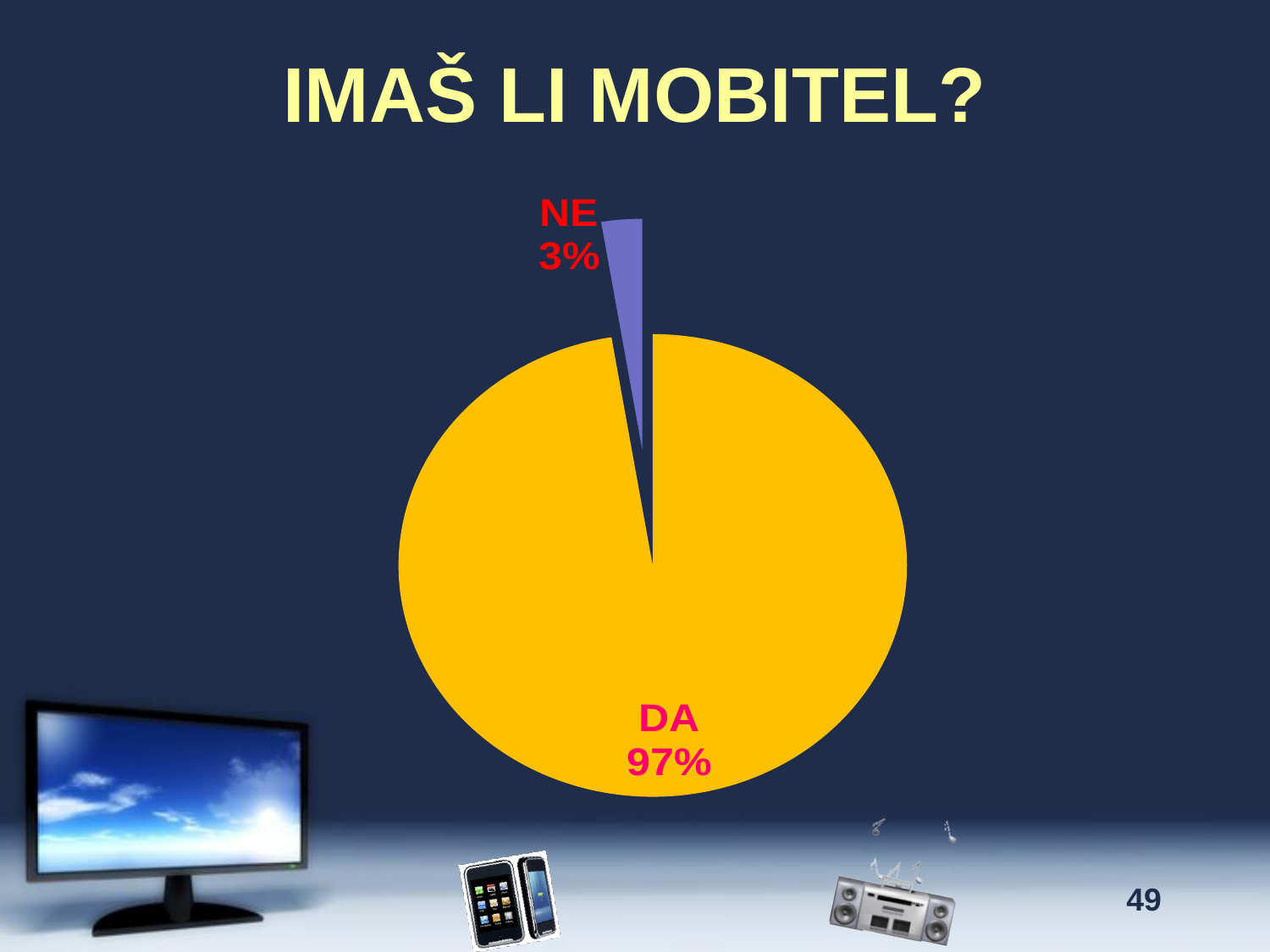
What colour is the DA slice of the pie? yellow Which answer has the smallest share of the pie? NE What is the difference in percentage points between DA and NE? 94 What kind of chart is shown on the slide? pie chart Which answer has the largest share of the pie? DA What is the title of the slide above the chart? IMAŠ LI MOBITEL? What percentage of respondents answered NE? 3% What percentage of respondents answered DA? 97% How many slices does the pie chart have? 2 Which is larger, the share for DA or the share for NE? DA What share of the pie does the NE slice represent? 3%